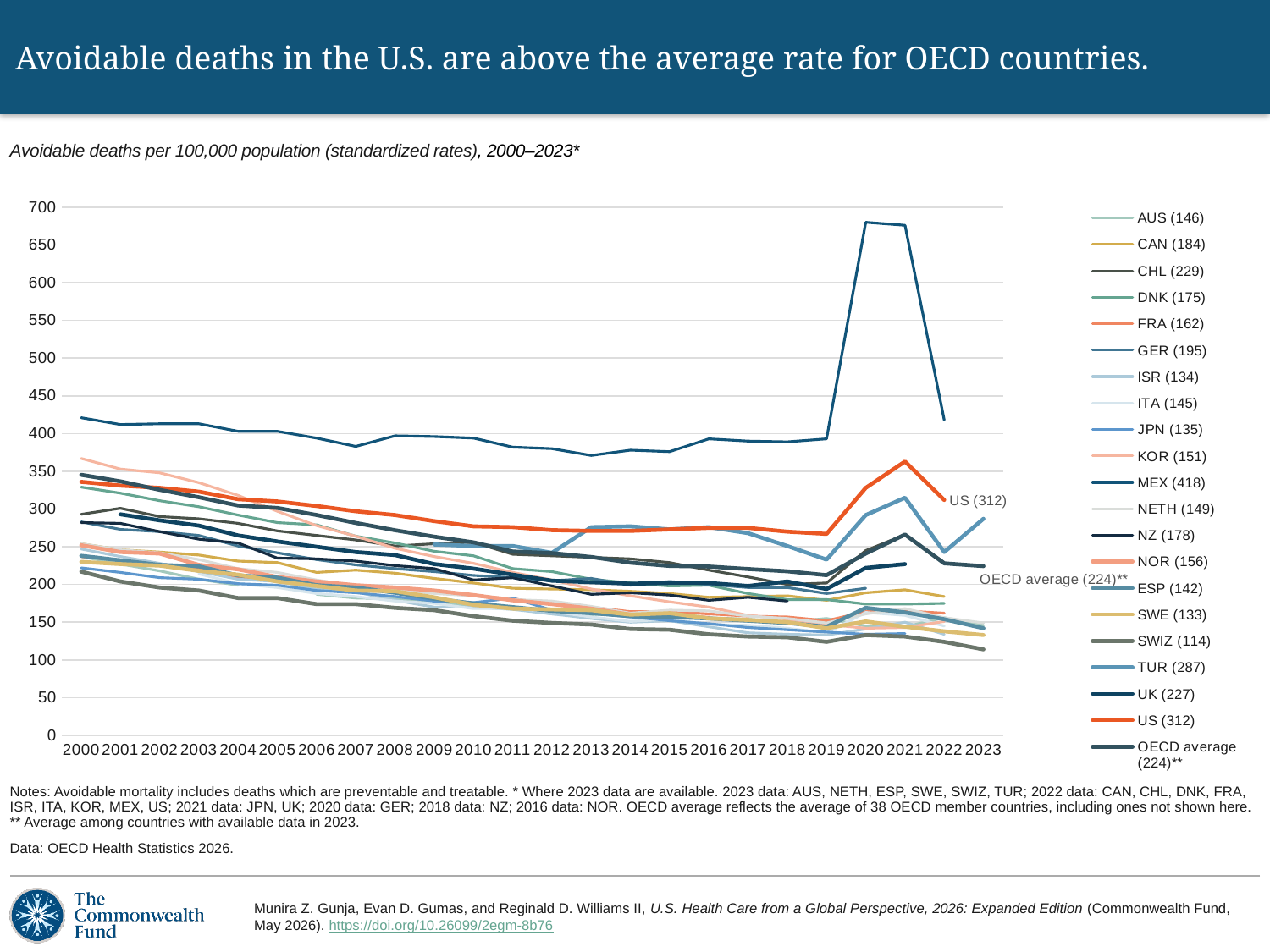
Is the value for the US in 2000 greater or less than 300? greater Which has a higher latest value, the US or the UK? US Which country has the lowest latest value in the legend? SWIZ (114) What is the latest avoidable deaths value for the US shown in the legend? 312 Which country has the highest latest value in the legend? MEX (418) What is the difference between the US value (312) and the OECD average (224)? 88 Is the value for MEX in 2020 greater or less than 650? greater What is the OECD average value shown in the legend? 224 What is the latest value for SWIZ shown in the legend? 114 How many years are shown on the x axis? 24 What type of chart is shown on the slide? line chart How many series does the legend list? 21